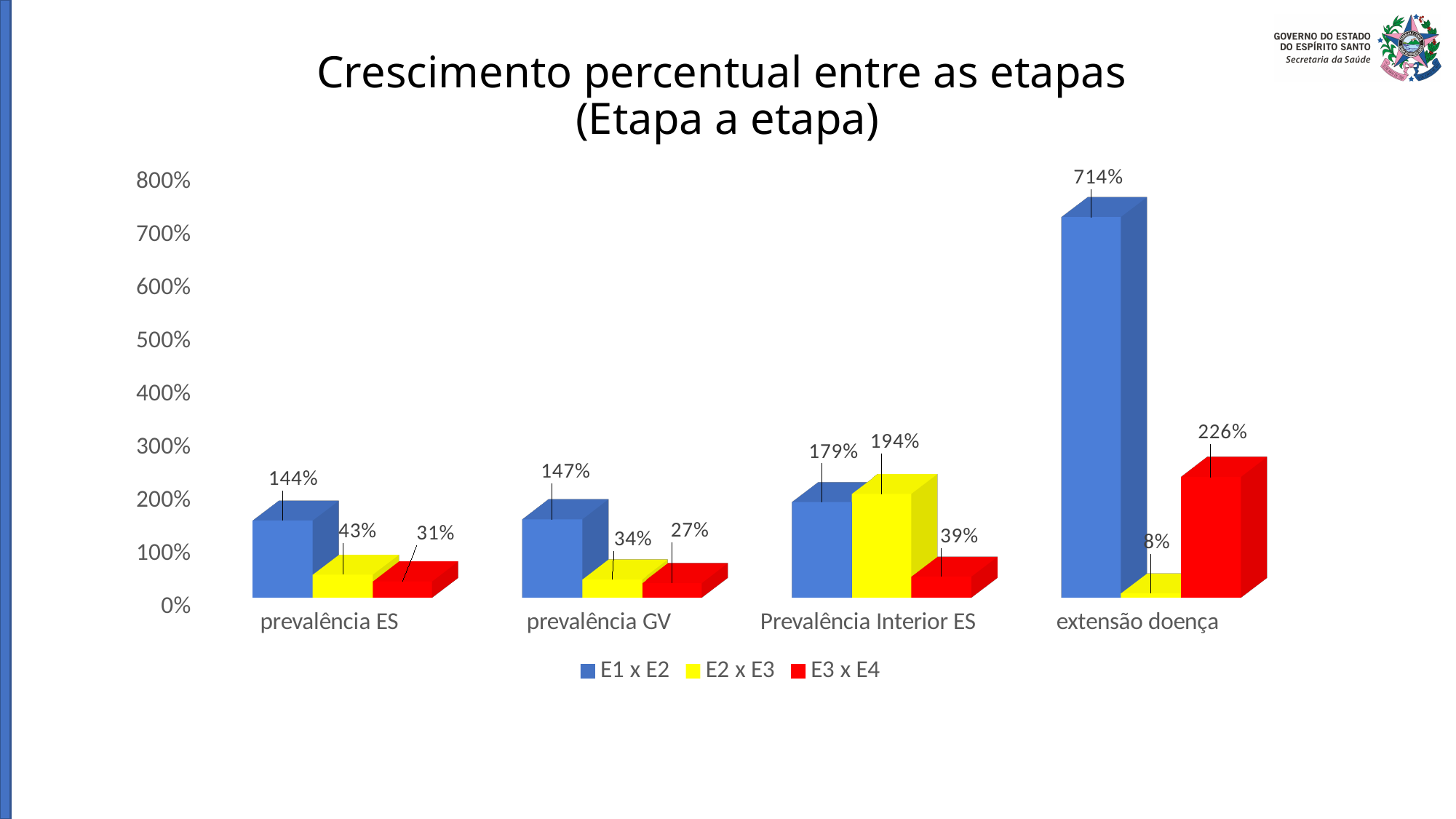
What is the E2 x E3 value for Prevalência Interior ES? 194% Which category has the lowest E2 x E3 value? extensão doença How many categories are shown on the x axis? 4 What kind of chart is shown on the slide? Bar chart What is the difference between the E1 x E2 value for extensão doença and the E1 x E2 value for prevalência ES? 570% What is the E1 x E2 value for prevalência ES? 144% Which category has the highest E1 x E2 value? extensão doença How many series does the legend list? 3 What is the E2 x E3 value for extensão doença? 8% What colour represents the E3 x E4 series? Red What is the E3 x E4 value for extensão doença? 226% Which is larger for Prevalência Interior ES: the E1 x E2 value or the E2 x E3 value? E2 x E3